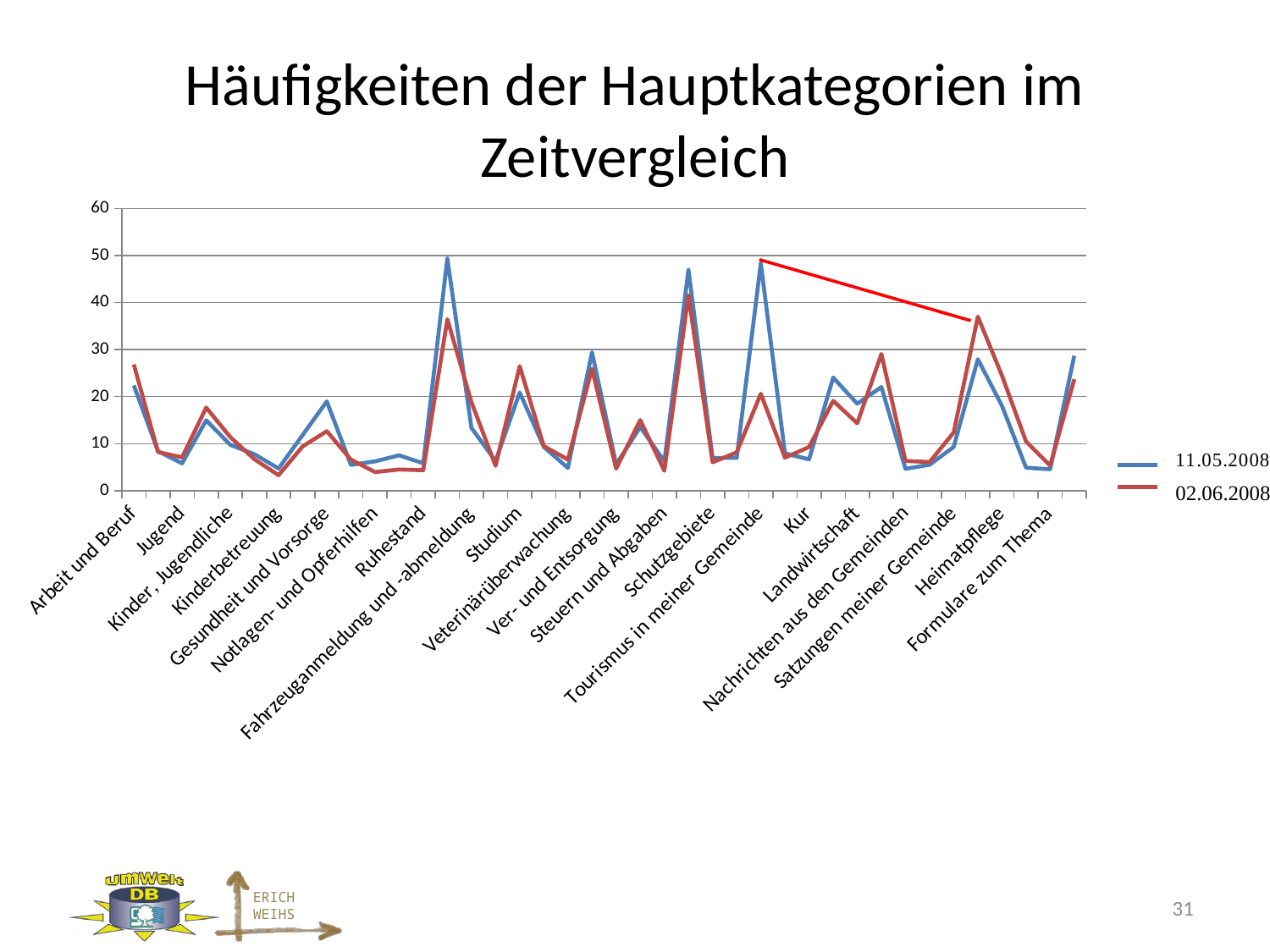
Is the highest value reached by the 11.05.2008 series greater or less than 40? greater What are the two series named in the legend? 11.05.2008 and 02.06.2008 Is the highest value reached by the 02.06.2008 series greater or less than 30? greater Is the value for Arbeit und Beruf in the 02.06.2008 series greater or less than 20? greater How many series does the legend list? 2 Which series reaches the higher peak value overall, 11.05.2008 or 02.06.2008? 11.05.2008 For Arbeit und Beruf, which series has the higher value, 11.05.2008 or 02.06.2008? 02.06.2008 What is the title of the chart? Häufigkeiten der Hauptkategorien im Zeitvergleich What kind of chart is shown on the slide? line chart